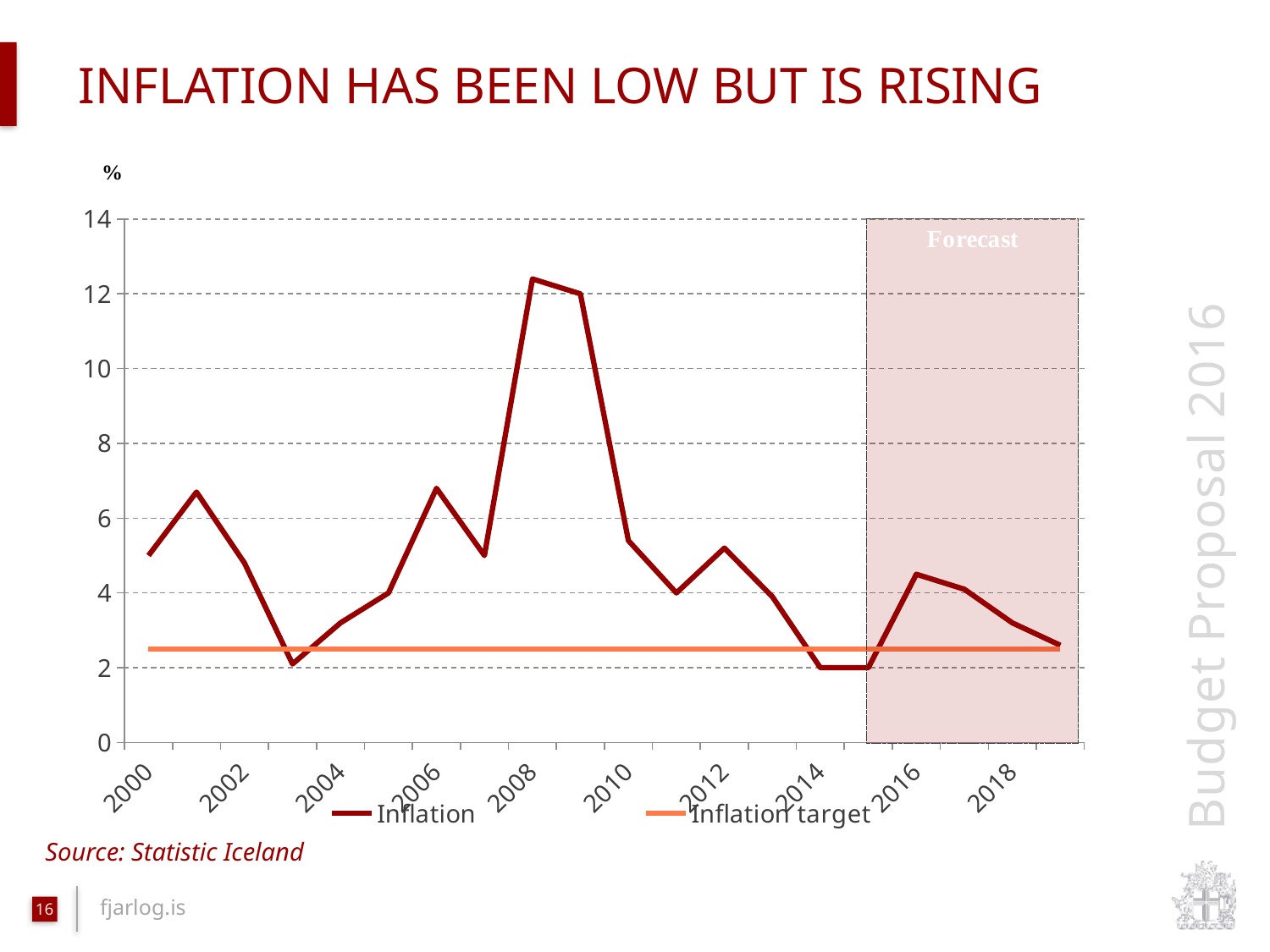
Is the Inflation value for 2016 greater or less than 4? greater What kind of chart is shown on the slide? Line chart Is the Inflation value for 2014 greater or less than 4? less Does the Inflation line rise or fall from 2016 to 2019? Fall Which year has the higher Inflation value, 2001 or 2003? 2001 What is the title of the slide? INFLATION HAS BEEN LOW BUT IS RISING How many series does the legend list? 2 What label is shown in the shaded area on the right of the chart? Forecast Is the Inflation value for 2008 greater or less than 10? greater Which year has the higher Inflation value, 2008 or 2012? 2008 In which year does the Inflation line reach its highest value? 2008